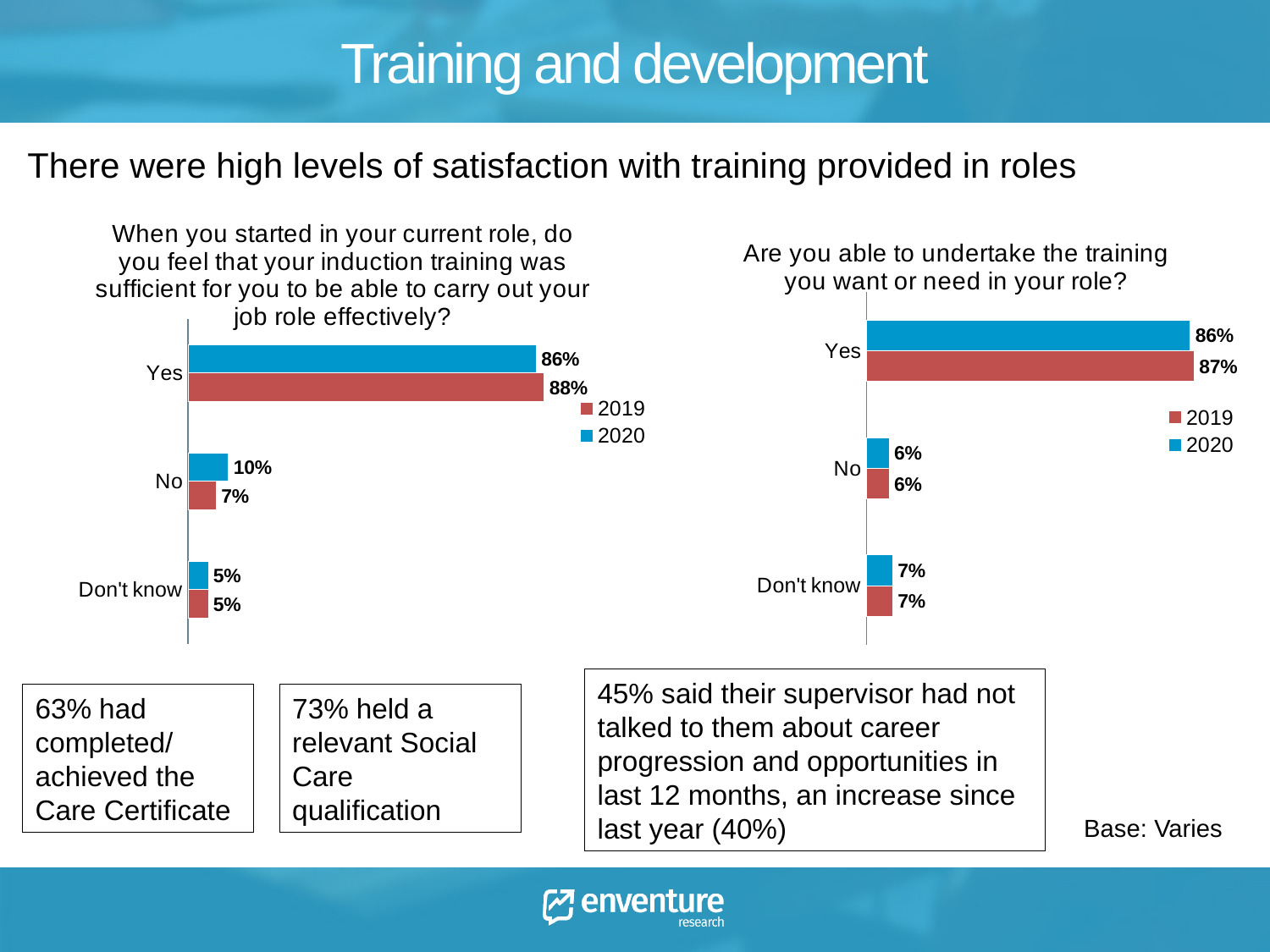
In the right chart about being able to undertake training, which response had the lowest value in 2020? No In the left chart about induction training, what is the difference between the 2019 and 2020 values for Yes? 2% In the left chart about induction training, what percentage answered Yes in 2020? 86% In the left chart about induction training, what percentage answered No in 2019? 7% In the right chart about being able to undertake training, what percentage answered Don't know in 2020? 7% How many response categories are shown in the right chart about being able to undertake training? 3 In the left chart about induction training, which response had the highest value in 2019? Yes In the left chart about induction training, which year had the larger value for No, 2019 or 2020? 2020 What type of chart is the right chart about being able to undertake training? Bar chart In the right chart about being able to undertake training, what percentage answered Yes in 2019? 87% How many series does the legend list in the left chart about induction training? 2 In the right chart about being able to undertake training, which colour represents 2020? Blue